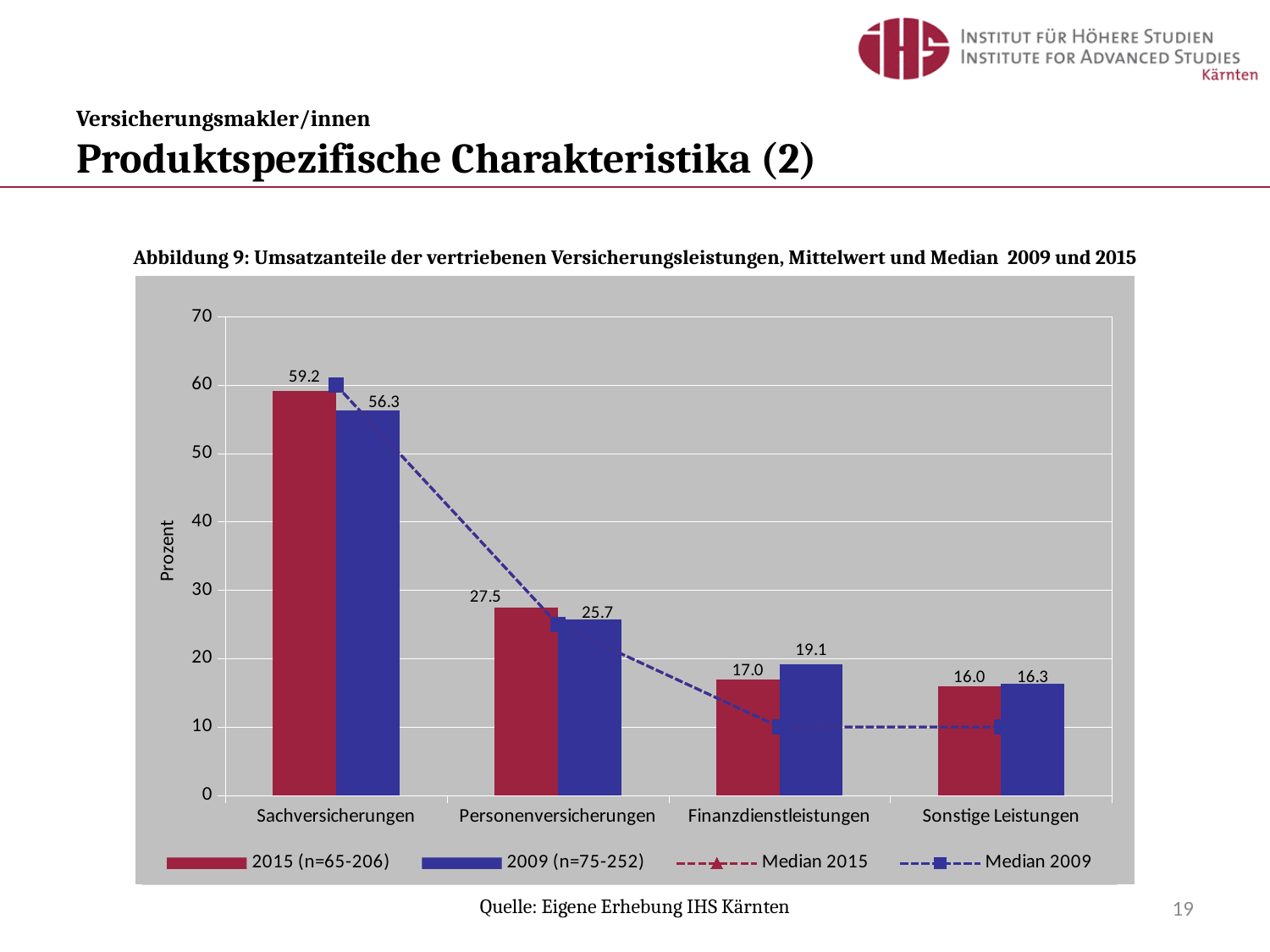
Is the Median 2009 value for Sachversicherungen greater or less than 50? greater Which category has the lowest value in the 2015 (n=65-206) series? Sonstige Leistungen What is the value for Sonstige Leistungen in the 2015 (n=65-206) series? 16.0 What is the value for Sachversicherungen in the 2015 (n=65-206) series? 59.2 What is the value for Finanzdienstleistungen in the 2009 (n=75-252) series? 19.1 How many series does the legend list? 4 For Finanzdienstleistungen, which is larger: the 2015 value or the 2009 value? 2009 Which category has the highest value in the 2009 (n=75-252) series? Sachversicherungen What is the difference between the 2015 and 2009 values for Sachversicherungen? 2.9 What is the label of the y axis? Prozent Is the Median 2009 value for Finanzdienstleistungen greater or less than 20? less How many categories are shown on the x axis? 4